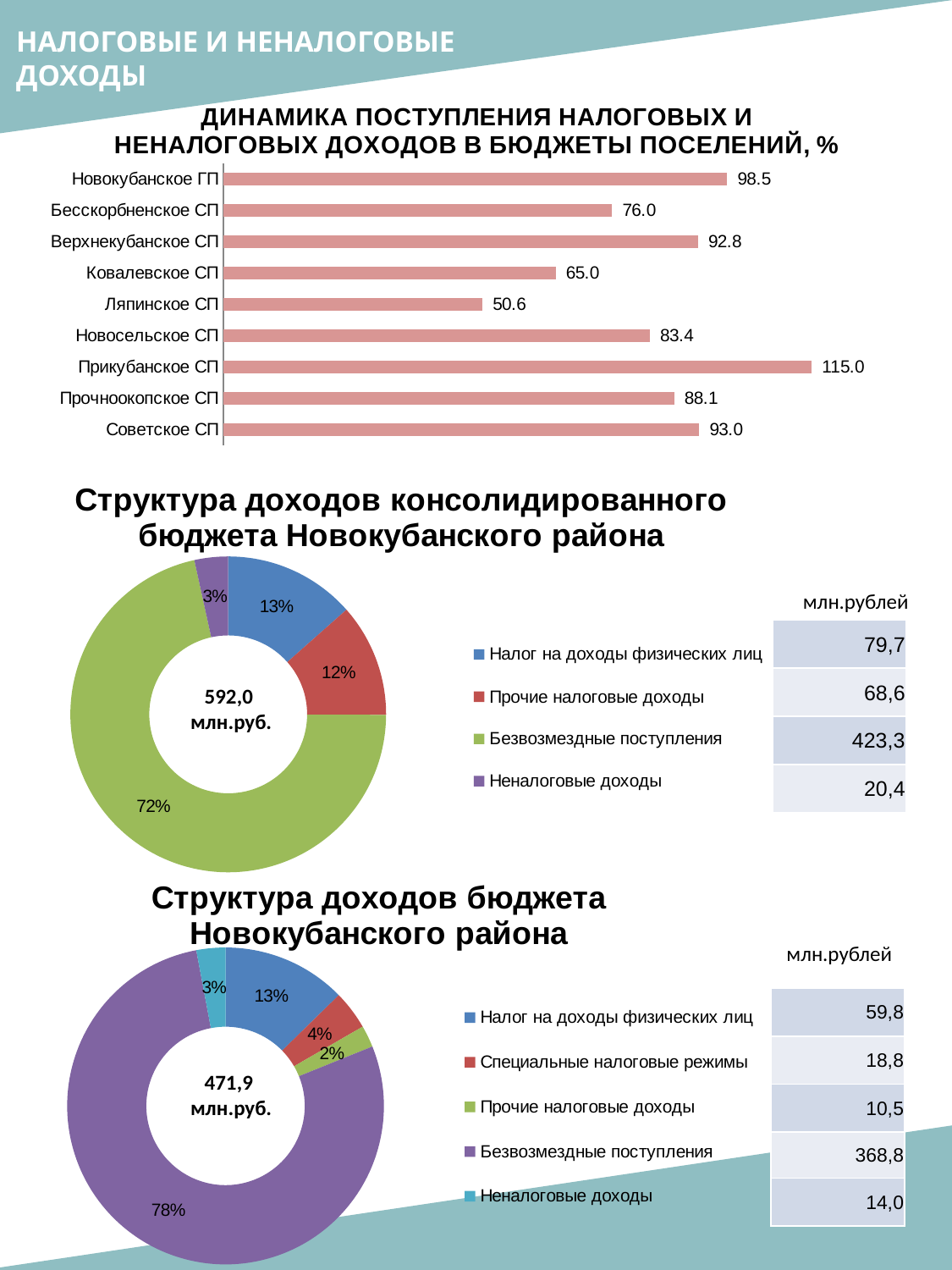
In the bar chart 'Динамика поступления налоговых и неналоговых доходов в бюджеты поселений, %', which settlement has the highest value? Прикубанское СП In the bar chart 'Динамика поступления налоговых и неналоговых доходов в бюджеты поселений, %', what is the difference between Новокубанское ГП and Бесскорбненское СП? 22.5 In the bar chart 'Динамика поступления налоговых и неналоговых доходов в бюджеты поселений, %', what is the value for Прикубанское СП? 115.0 In the bar chart 'Динамика поступления налоговых и неналоговых доходов в бюджеты поселений, %', which is larger: Советское СП or Прочноокопское СП? Советское СП In the chart 'Структура доходов консолидированного бюджета Новокубанского района', what is the value in млн.рублей for Налог на доходы физических лиц? 79,7 In the chart 'Структура доходов бюджета Новокубанского района', what is the value in млн.рублей for Специальные налоговые режимы? 18,8 How many settlements are shown in the bar chart 'Динамика поступления налоговых и неналоговых доходов в бюджеты поселений, %'? 9 What type of chart is 'Динамика поступления налоговых и неналоговых доходов в бюджеты поселений, %'? Bar chart In the chart 'Структура доходов бюджета Новокубанского района', what total in млн.руб. is shown in the centre of the doughnut? 471,9 млн.руб. How many categories does the legend list in the chart 'Структура доходов консолидированного бюджета Новокубанского района'? 4 In the bar chart 'Динамика поступления налоговых и неналоговых доходов в бюджеты поселений, %', which settlement has the lowest value? Ляпинское СП In the chart 'Структура доходов консолидированного бюджета Новокубанского района', what share do Безвозмездные поступления make up? 72%